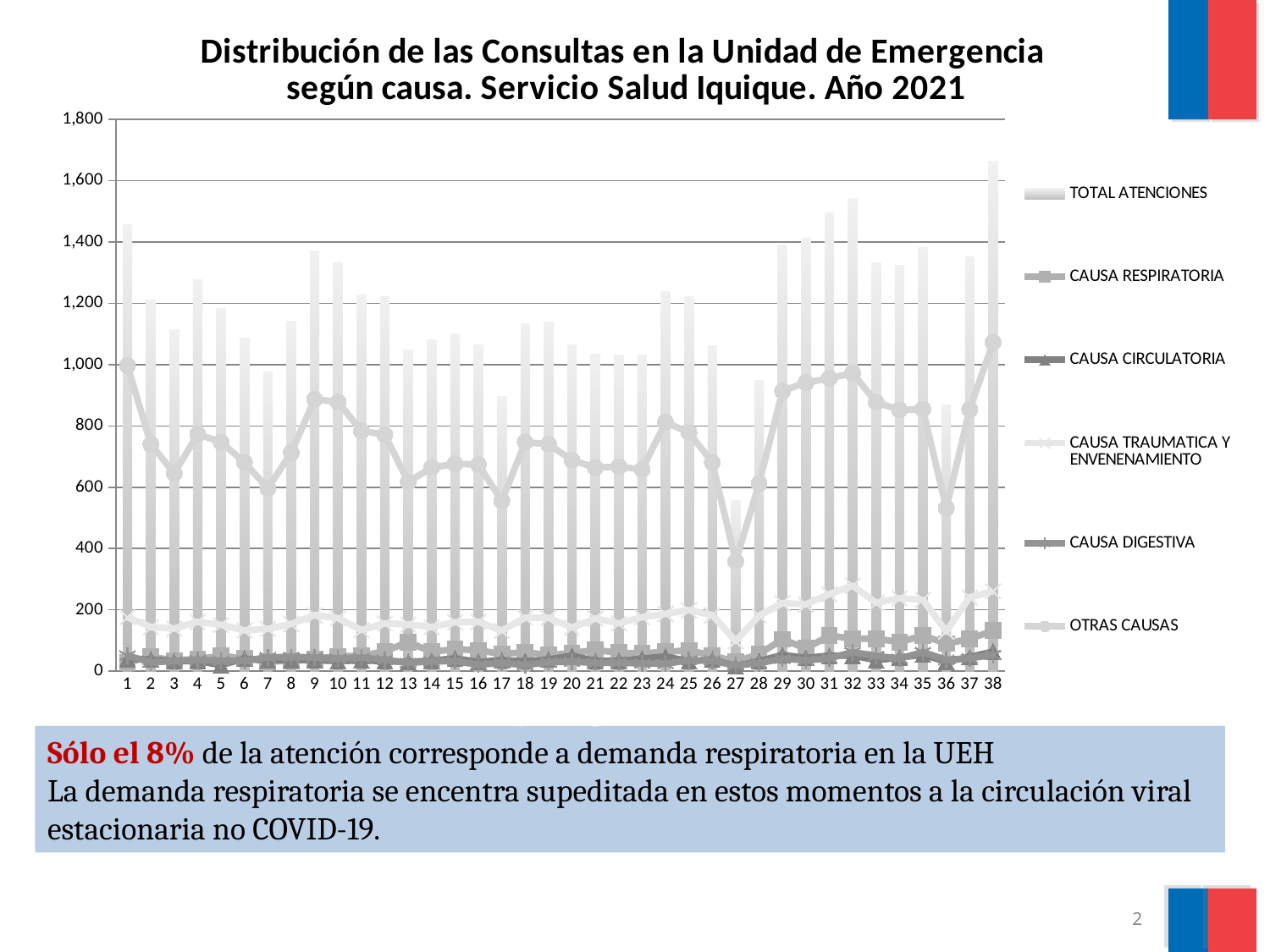
At which x-axis point is TOTAL ATENCIONES lowest? 27 Is the value of TOTAL ATENCIONES at point 27 greater or less than 800? less Which series is drawn as bars rather than a line? TOTAL ATENCIONES Does OTRAS CAUSAS rise or fall from point 27 to point 31? Rise What is the title of the chart? Distribución de las Consultas en la Unidad de Emergencia según causa. Servicio Salud Iquique. Año 2021 Is the value of OTRAS CAUSAS at point 9 greater or less than 800? greater At which x-axis point is TOTAL ATENCIONES highest? 38 How many series does the legend list? 6 How many points are there along the x axis? 38 Is the value of TOTAL ATENCIONES at point 38 greater or less than 1,400? greater Which is larger, TOTAL ATENCIONES at point 1 or at point 2? Point 1 What kind of chart is shown on the slide? A combined bar and line chart